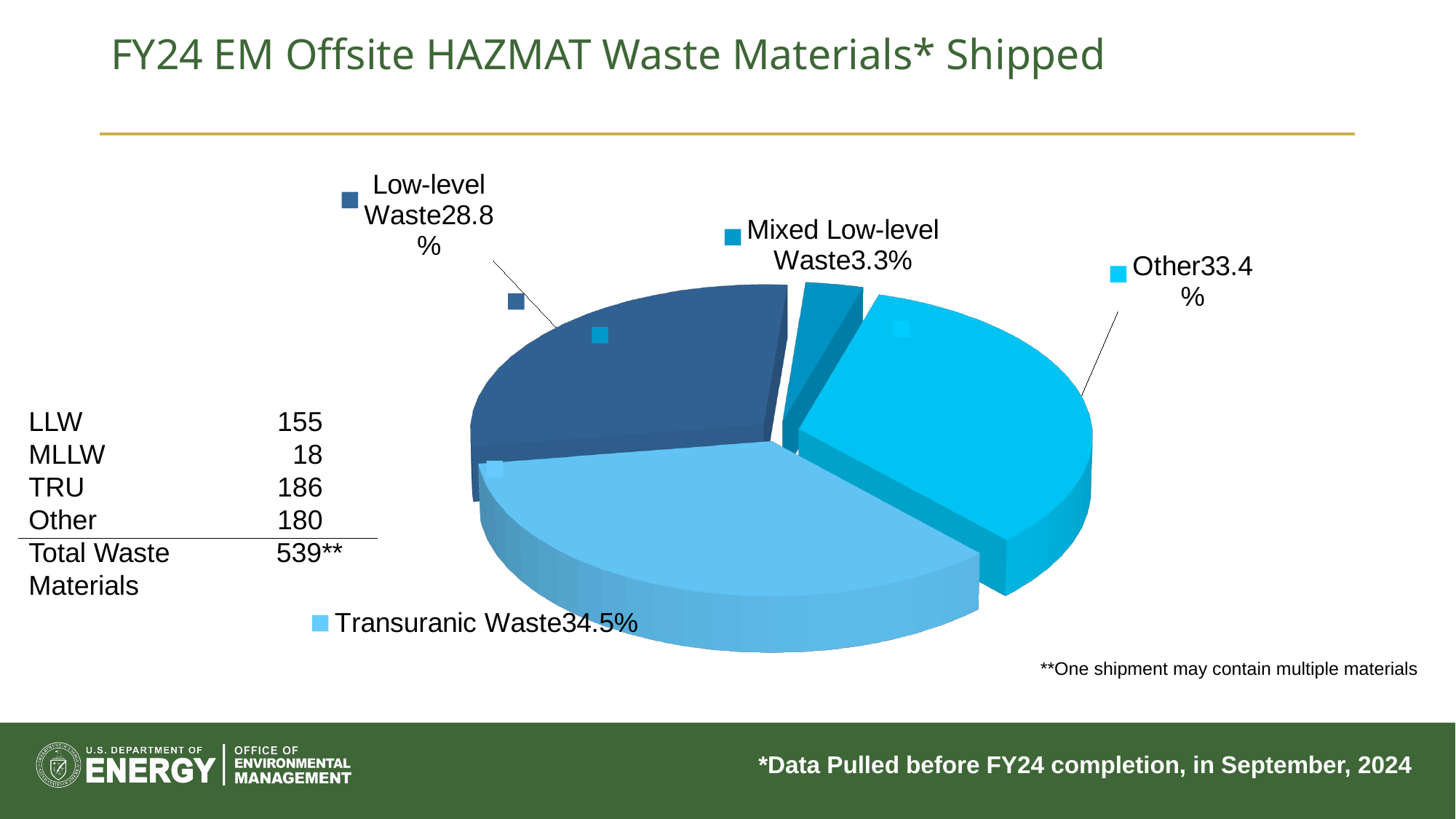
What kind of chart is shown on the slide? pie chart What share of the pie does the Other category represent? 33.4% What is the difference in percentage points between the Low-level Waste share and the Mixed Low-level Waste share? 25.5 What share of the pie does Transuranic Waste represent? 34.5% What share of the pie does Low-level Waste represent? 28.8% What is the difference in percentage points between the Transuranic Waste share and the Other share? 1.1 What is the title of the slide's chart? FY24 EM Offsite HAZMAT Waste Materials* Shipped Which has a larger share of the pie, Low-level Waste or Other? Other Which category has the smallest share of the pie? Mixed Low-level Waste How many slices does the pie chart have? 4 Which category has the largest share of the pie? Transuranic Waste